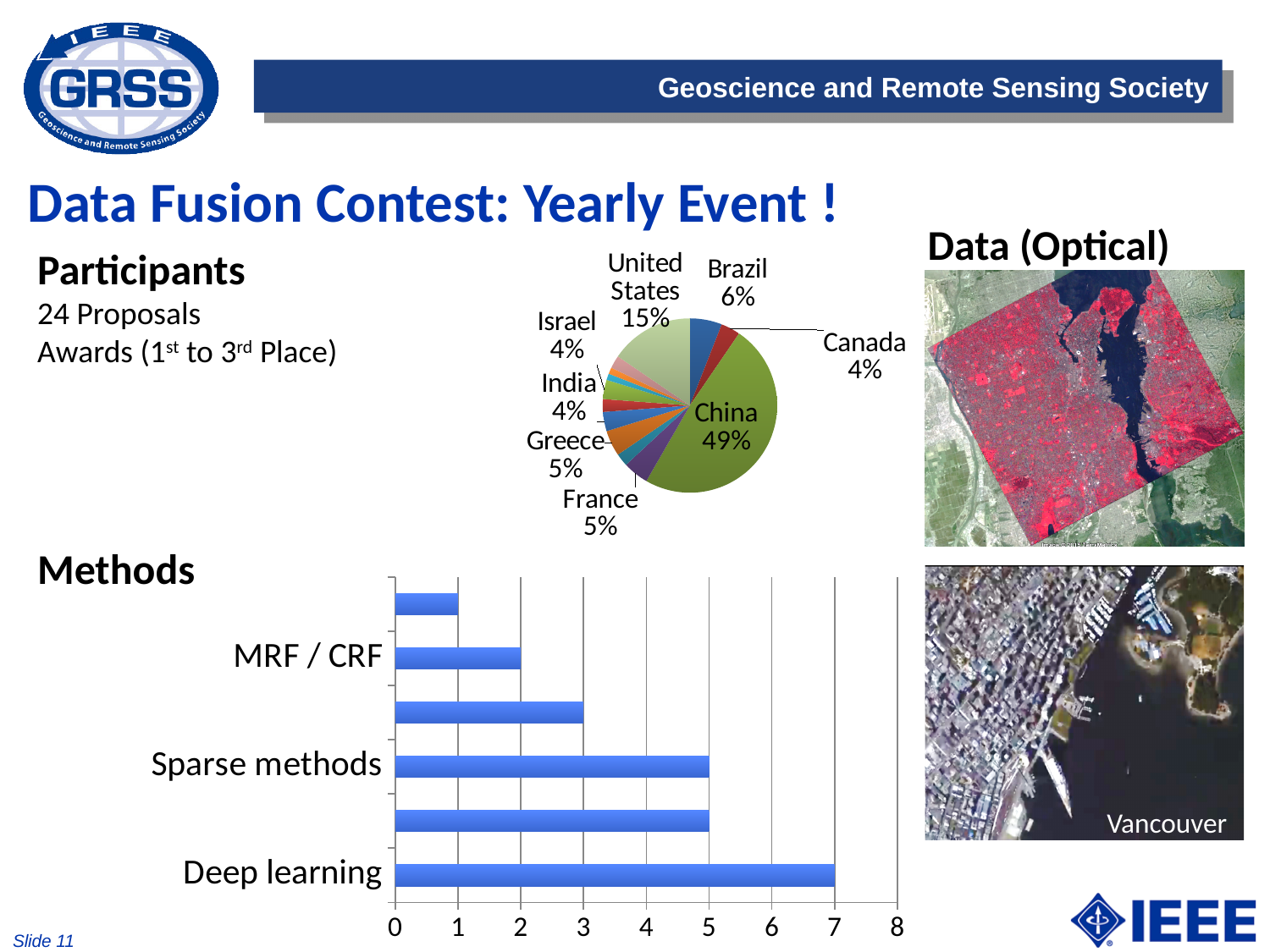
In the Methods bar chart, what is the value for Sparse methods? 5 In the Methods bar chart, what is the difference between the values for Deep learning and Sparse methods? 2 In the Participants pie chart, how many percentage points larger is China's share than the United States' share? 34 In the Participants pie chart, which country has the largest slice? China What kind of chart is the Methods chart? Bar chart In the Participants pie chart, what share of participants is from China? 49% In the Participants pie chart, what share of participants is from the United States? 15% In the Participants pie chart, which has the larger share, the United States or Brazil? United States In the Methods bar chart, which method has the longest bar? Deep learning In the Methods bar chart, what is the value for MRF / CRF? 2 In the Methods bar chart, what is the value for Deep learning? 7 In the Participants pie chart, what share of participants is from Brazil? 6%